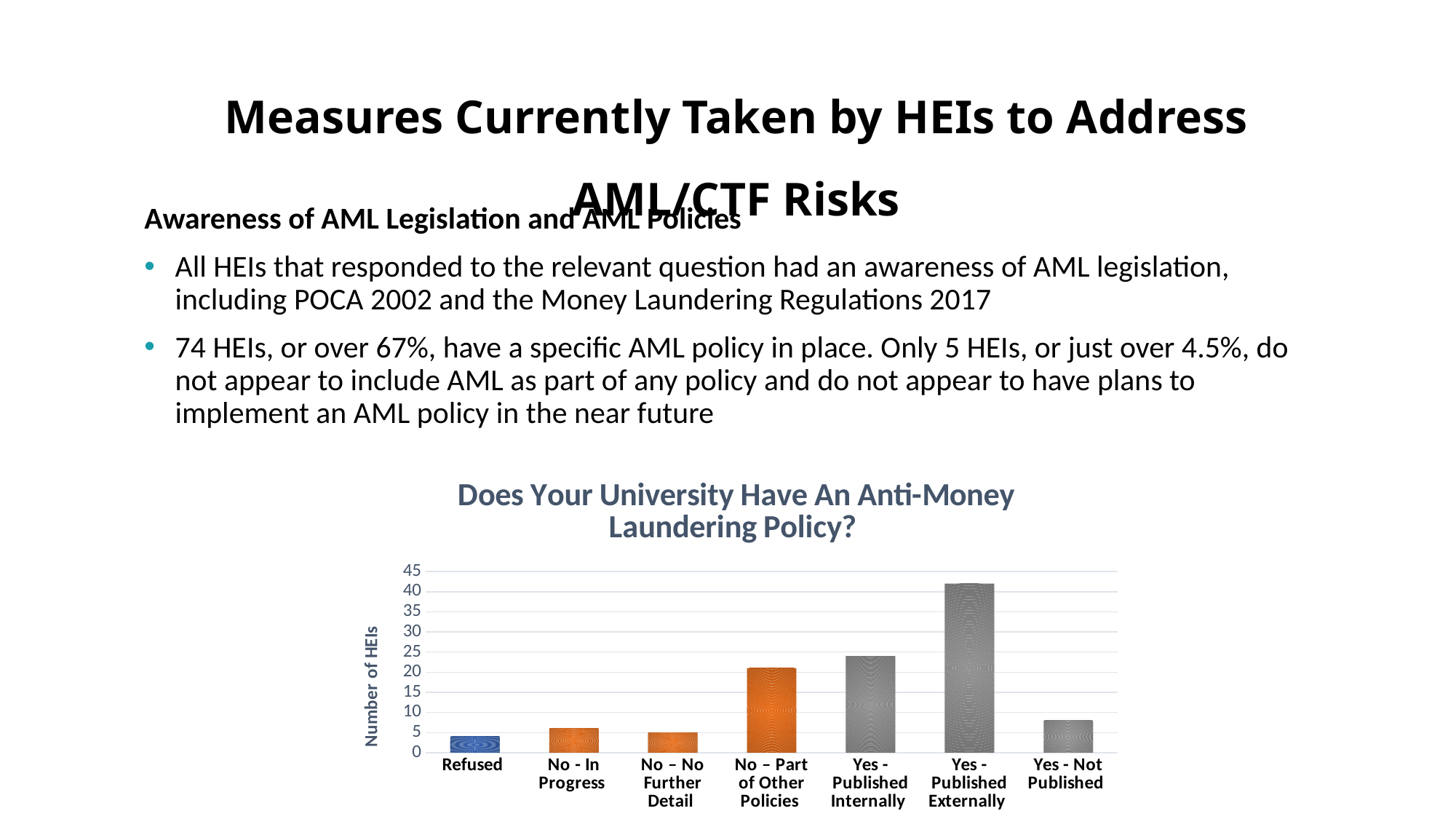
Is the value for Yes - Published Externally greater or less than 35? greater Is the value for Yes - Not Published greater or less than 10? less What is the title of the chart? Does Your University Have An Anti-Money Laundering Policy? Which is larger, the value for Yes - Published Externally or the value for Yes - Published Internally? Yes - Published Externally Which category has the highest number of HEIs? Yes - Published Externally Is the value for Refused greater or less than 10? less How many categories are shown on the x axis of the chart? 7 Which is larger, the value for No – Part of Other Policies or the value for No - In Progress? No – Part of Other Policies What is the label on the vertical axis of the chart? Number of HEIs What type of chart is shown on the slide? Bar chart